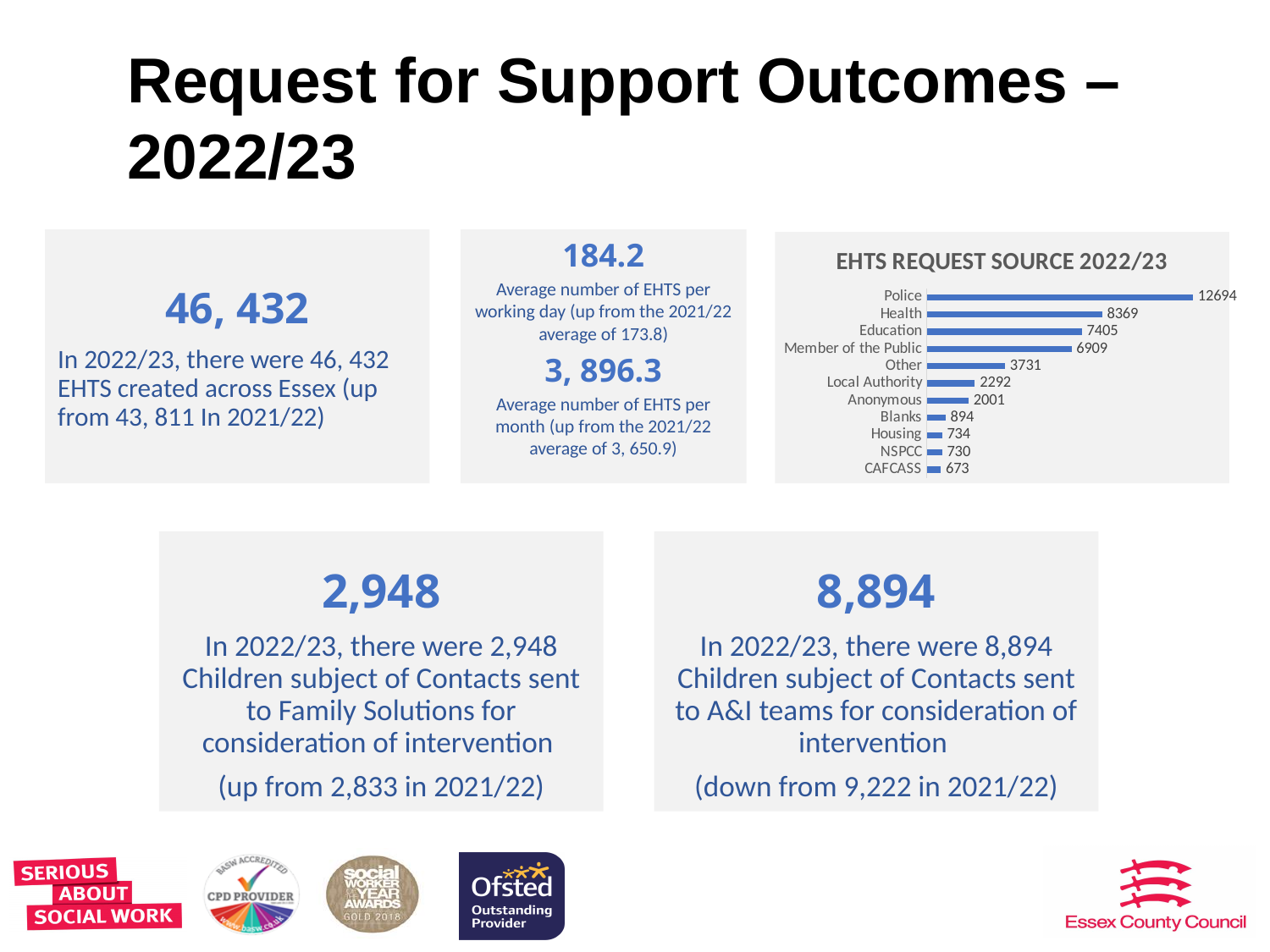
What kind of chart is the EHTS Request Source 2022/23 chart? Bar chart What is the title of the chart on the slide? EHTS REQUEST SOURCE 2022/23 Which request source has the highest value in the EHTS Request Source 2022/23 chart? Police What is the value for Member of the Public in the EHTS Request Source 2022/23 chart? 6909 What is the difference between the Police and Health values in the EHTS Request Source 2022/23 chart? 4325 How many request source categories are shown in the EHTS Request Source 2022/23 chart? 11 Which request source has the lowest value in the EHTS Request Source 2022/23 chart? CAFCASS What is the value for Blanks in the EHTS Request Source 2022/23 chart? 894 Which is larger in the EHTS Request Source 2022/23 chart, Other or Anonymous? Other What is the value for Local Authority in the EHTS Request Source 2022/23 chart? 2292 What is the difference between the Health and Education values in the EHTS Request Source 2022/23 chart? 964 What is the value for Police in the EHTS Request Source 2022/23 chart? 12694